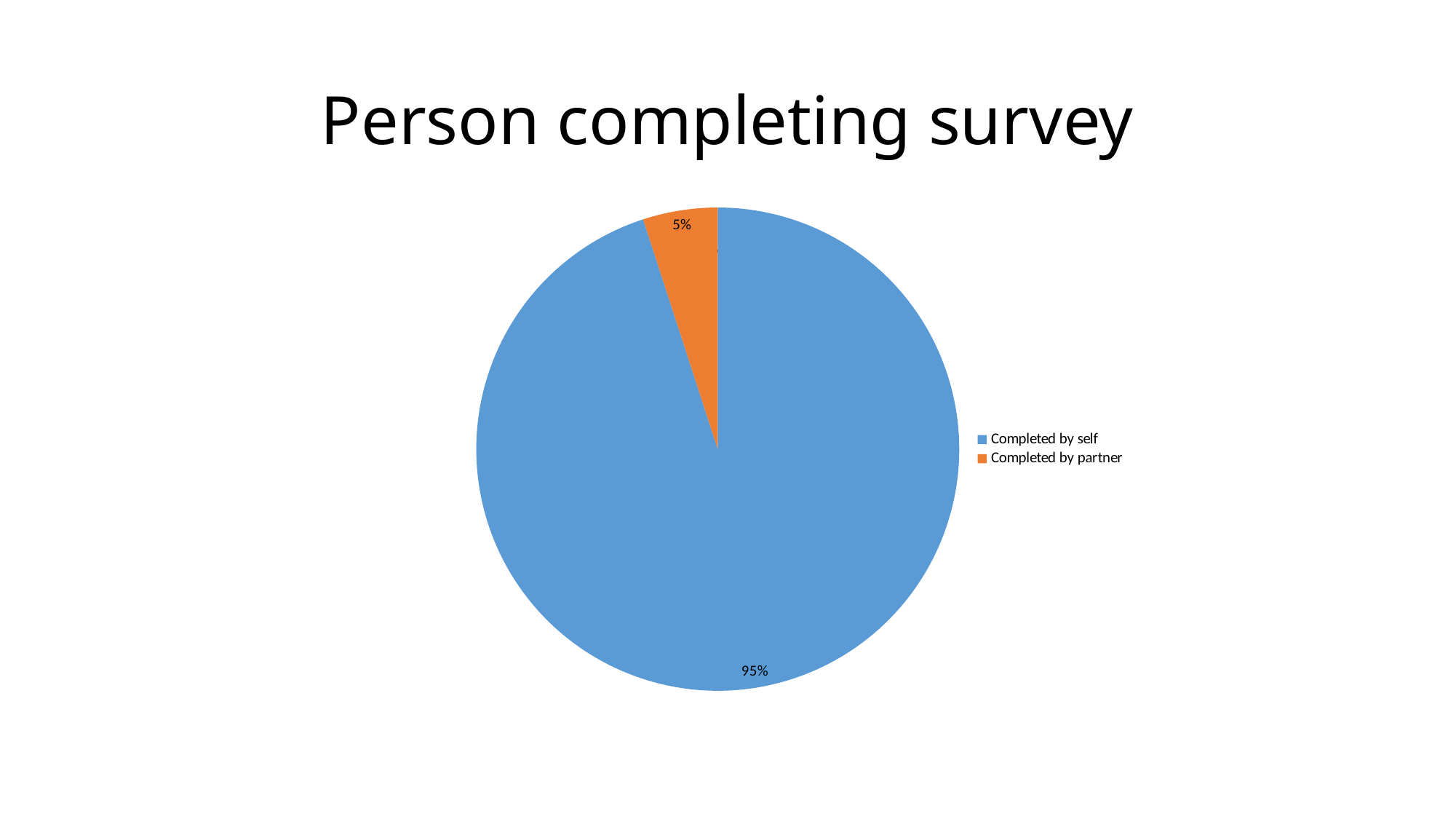
How many categories does the pie chart show? 2 What is the difference in percentage points between 'Completed by self' and 'Completed by partner'? 90 How many entries does the legend list? 2 Which category has the smallest slice of the pie? Completed by partner What colour is the 'Completed by partner' slice? orange What share of the pie is 'Completed by self'? 95% What is the title of the chart? Person completing survey What share of the pie is 'Completed by partner'? 5% What kind of chart is shown on the slide? pie chart Which is larger, the share for 'Completed by self' or 'Completed by partner'? Completed by self Which category has the largest slice of the pie? Completed by self